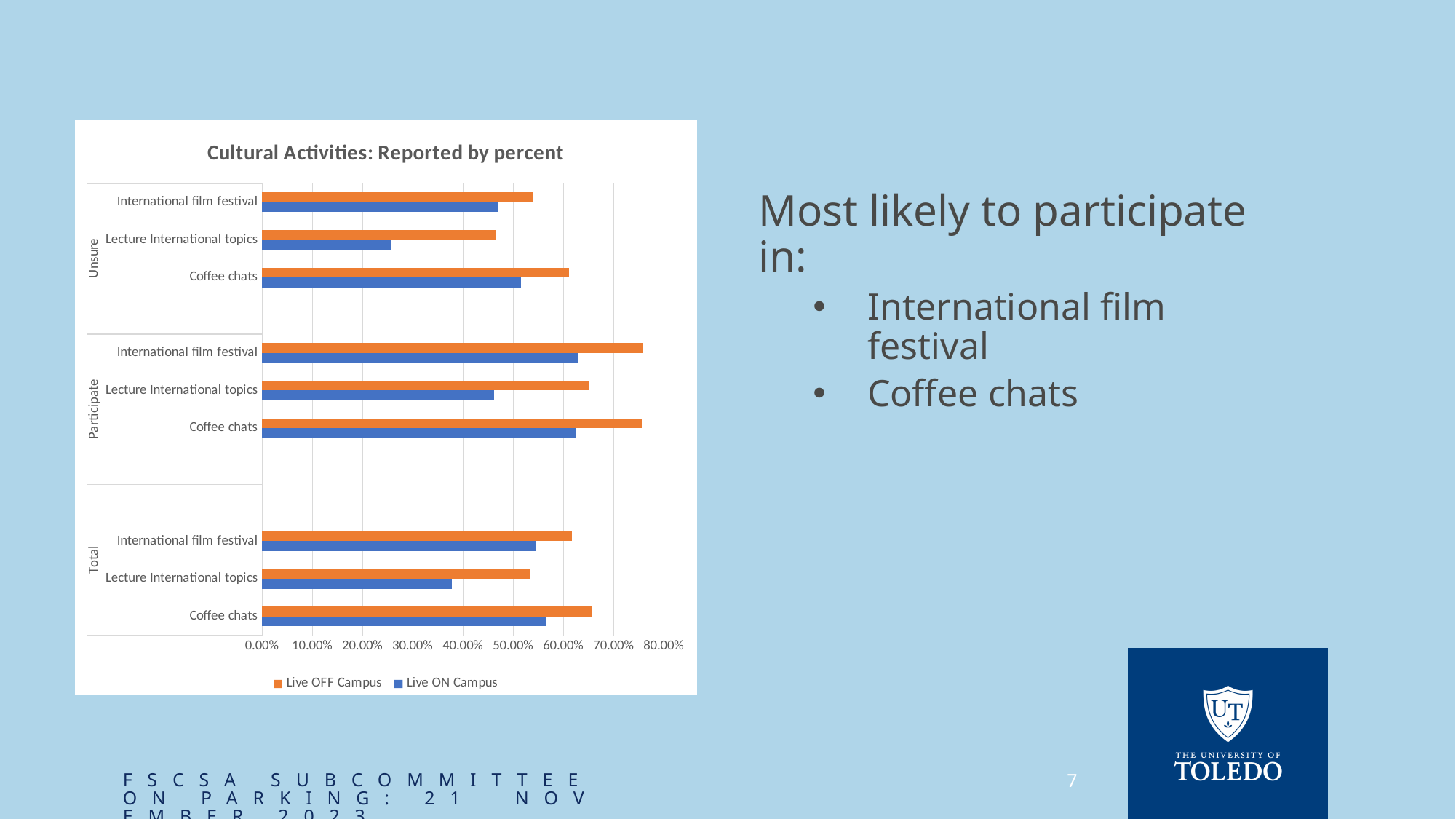
In the Participate group, is the Live OFF Campus value for International film festival greater or less than 70.00%? greater In the Participate group, which activity has the lowest Live ON Campus value? Lecture International topics How many activities are listed within each response group? 3 In the Total group, is the Live ON Campus value for Lecture International topics greater or less than 50.00%? less In the Participate group, which is larger for Lecture International topics: Live OFF Campus or Live ON Campus? Live OFF Campus What are the two series named in the legend? Live OFF Campus and Live ON Campus How many response groups (Unsure, Participate, Total) are shown on the vertical axis? 3 How many series does the legend list? 2 What is the title of the chart? Cultural Activities: Reported by percent What kind of chart is shown on the slide? bar chart In the Total group, which activity has the highest Live OFF Campus value? Coffee chats In the Unsure group, is the Live ON Campus value for Lecture International topics greater or less than 30.00%? less